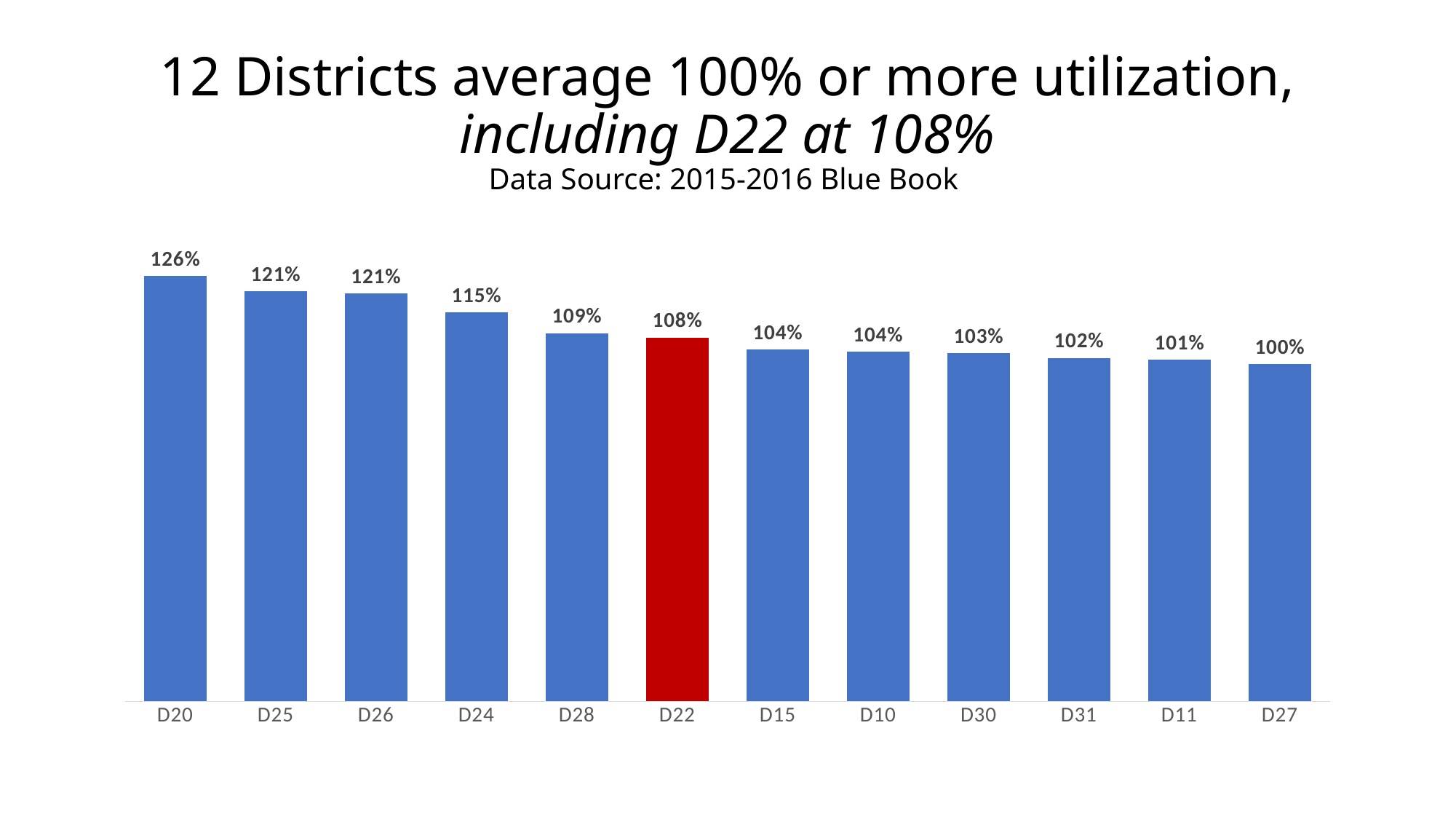
Which district's bar is coloured red? D22 Which district has the highest utilization? D20 Which has a higher utilization, D28 or D15? D28 What is the utilization value for D20? 126% How many districts are shown in the chart? 12 What is the utilization value for D30? 103% Do the values rise or fall from left to right along the x axis? Fall What is the difference between the utilization of D20 and D27? 26% What kind of chart is shown on the slide? Bar chart What is the difference between the utilization of D24 and D22? 7% What is the utilization value for D22? 108% Which district has the lowest utilization? D27